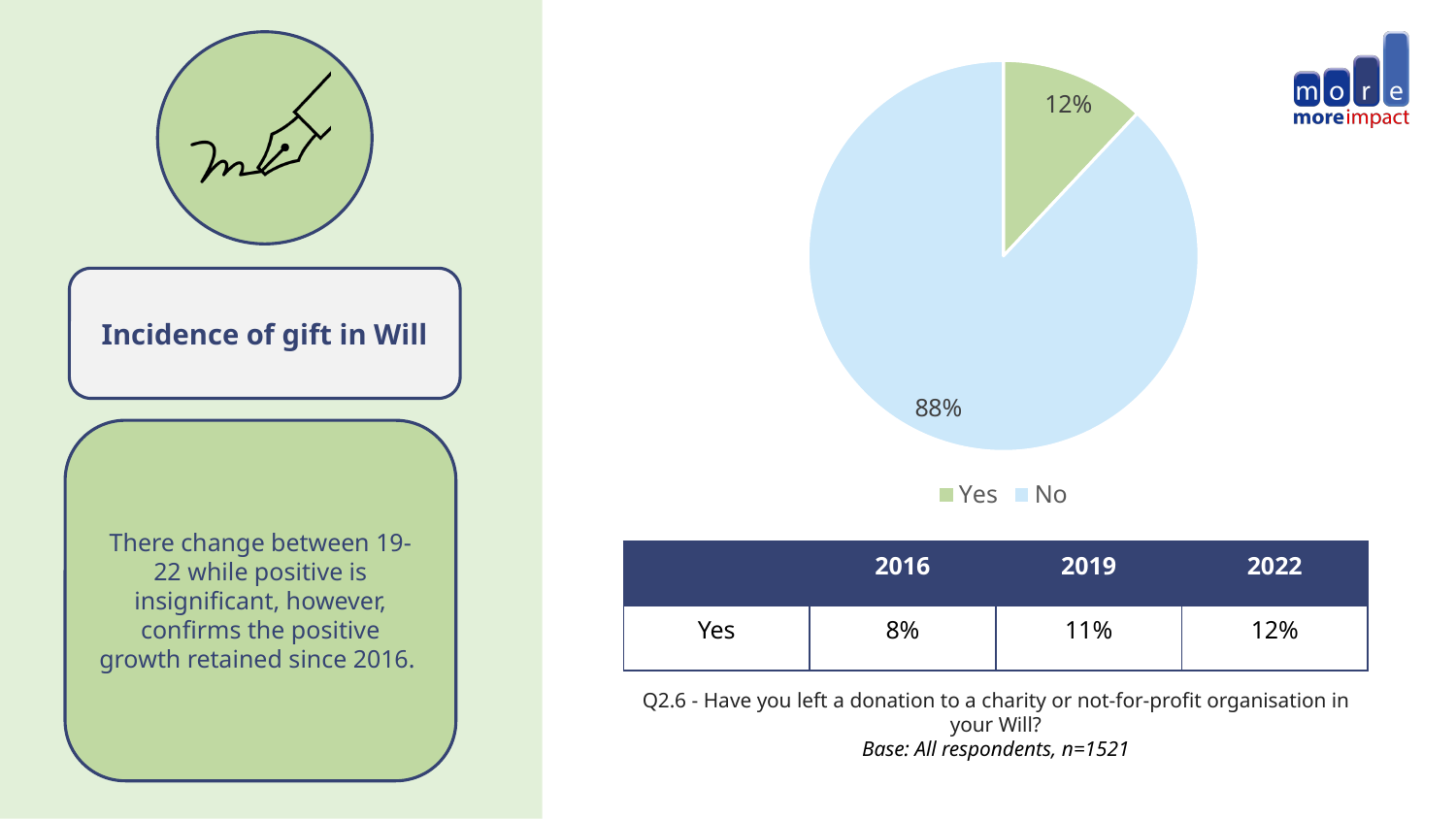
Which slice of the pie chart is the smallest? Yes What percentage of respondents answered No in the pie chart? 88% How many slices does the pie chart have? 2 Which slice of the pie chart is the largest? No How many entries does the pie chart legend list? 2 What kind of chart is shown on the slide? pie chart What colour is the No slice in the pie chart? light blue Which is larger in the pie chart, the Yes slice or the No slice? No What is the difference in percentage points between the No slice and the Yes slice? 76 What colour is the Yes slice in the pie chart? green What share of the pie does the Yes slice represent? 12% What percentage of respondents answered Yes in the pie chart? 12%